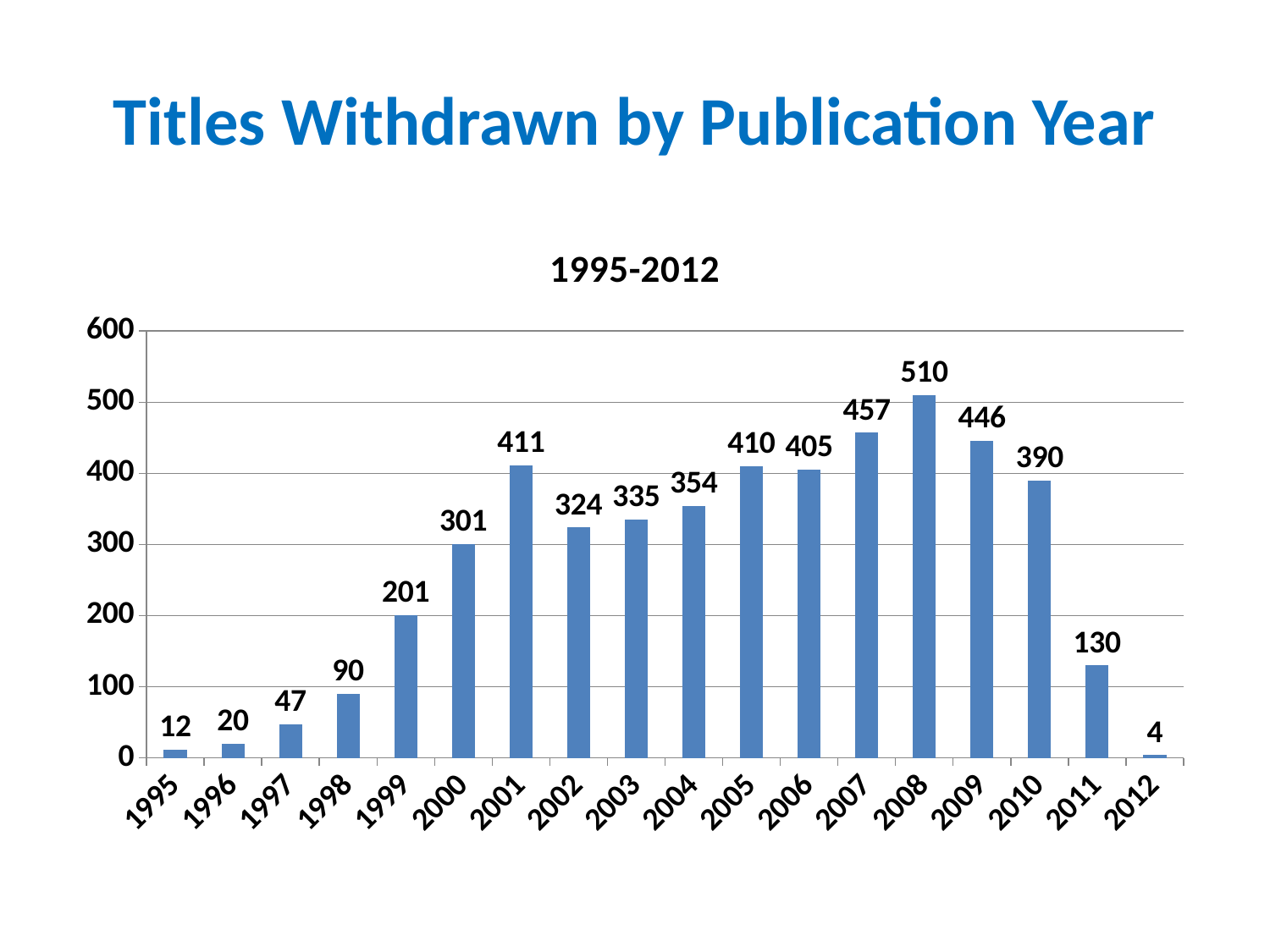
What is the value for 2011? 130 Which year has the lowest value? 2012 What is the difference between the values for 2001 and 2002? 87 Do the values rise or fall from 1995 to 2001? rise What is the difference between the values for 2008 and 2009? 64 Is the value for 2000 greater or less than 400? less How many years are shown on the x axis? 18 Which year has the highest value? 2008 What kind of chart is shown on the slide? bar chart What is the value for 1999? 201 Which is larger, the value for 2007 or the value for 2010? 2007 What is the value for 2008? 510